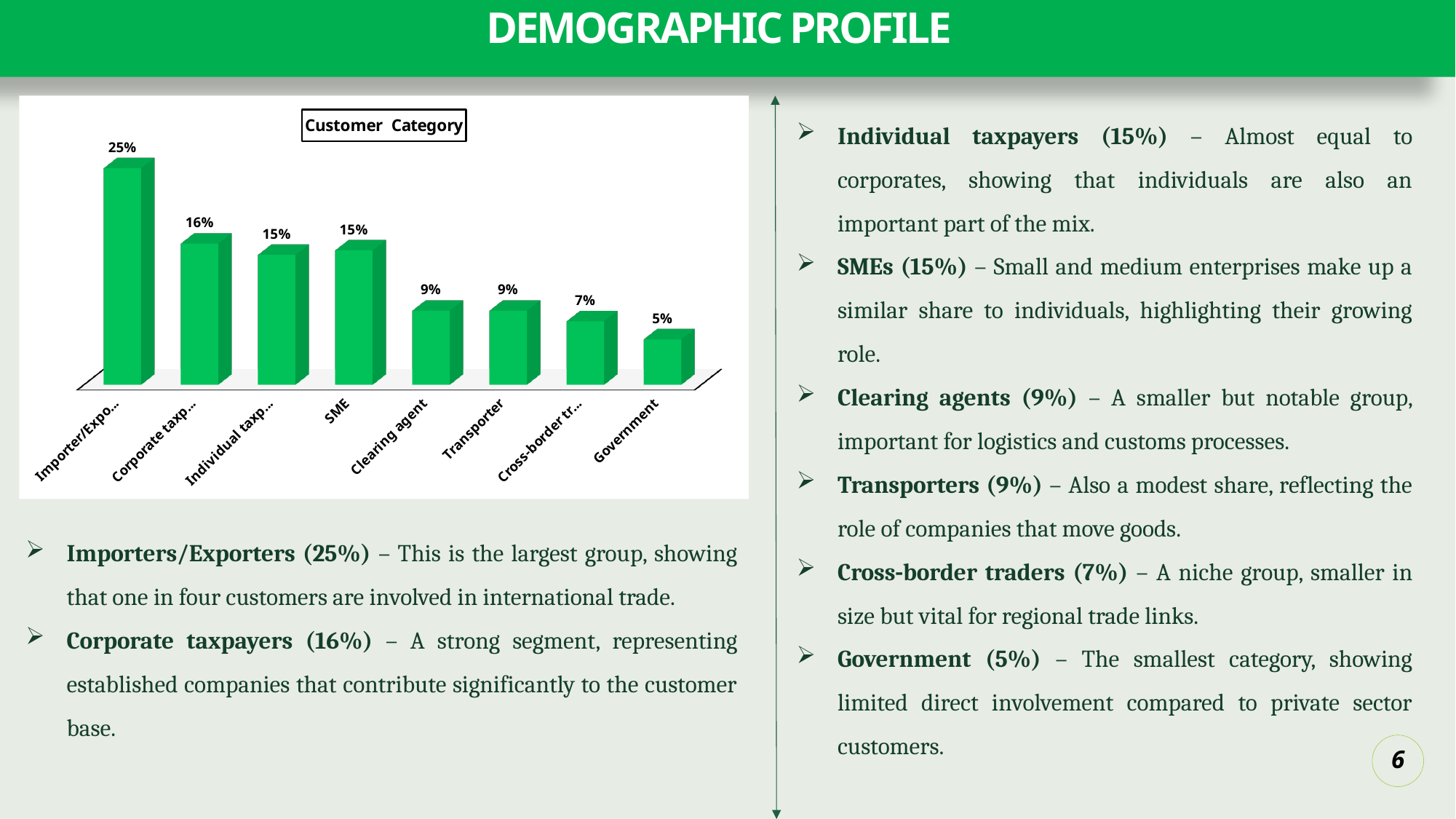
What is the title of the chart on the slide? Customer Category How many categories are shown in the Customer Category chart? 8 What is the value for SME in the Customer Category chart? 15% Which is larger in the Customer Category chart, the value for SME or the value for Transporter? SME Do the values in the Customer Category chart rise or fall from left to right? fall Which category has the highest value in the Customer Category chart? Importer/Exporter What is the value for Transporter in the Customer Category chart? 9% What is the value for Government in the Customer Category chart? 5% What is the difference between the values for SME and Government in the Customer Category chart? 10% Which category has the lowest value in the Customer Category chart? Government What type of chart is shown under the title "Customer Category"? bar chart What is the value for Clearing agent in the Customer Category chart? 9%